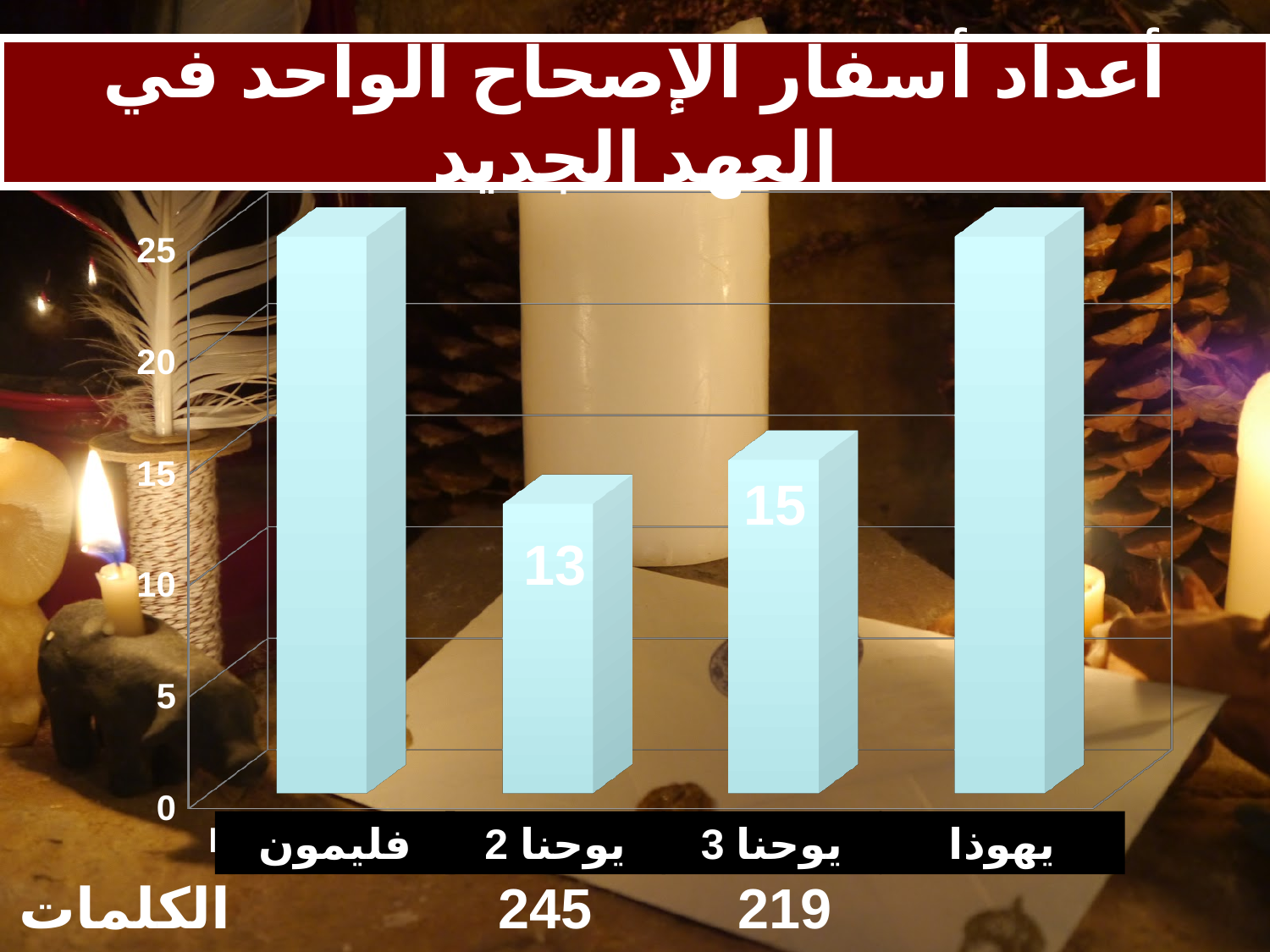
Is the value for يهوذا greater or less than 20? greater What is the highest value labelled on the vertical axis? 25 What kind of chart is shown on the slide? bar chart Which category has the lowest value? يوحنا 2 Which has the larger value, يوحنا 2 or يوحنا 3? يوحنا 3 Is the value for فليمون greater or less than 20? greater Which has the larger value, فليمون or يوحنا 3? فليمون What is the value shown for يوحنا 2? 13 How many categories are shown on the chart? 4 What is the difference between the values for يوحنا 3 and يوحنا 2? 2 What is the value shown for يوحنا 3? 15 What is the title of the chart? أعداد أسفار الإصحاح الواحد في العهد الجديد